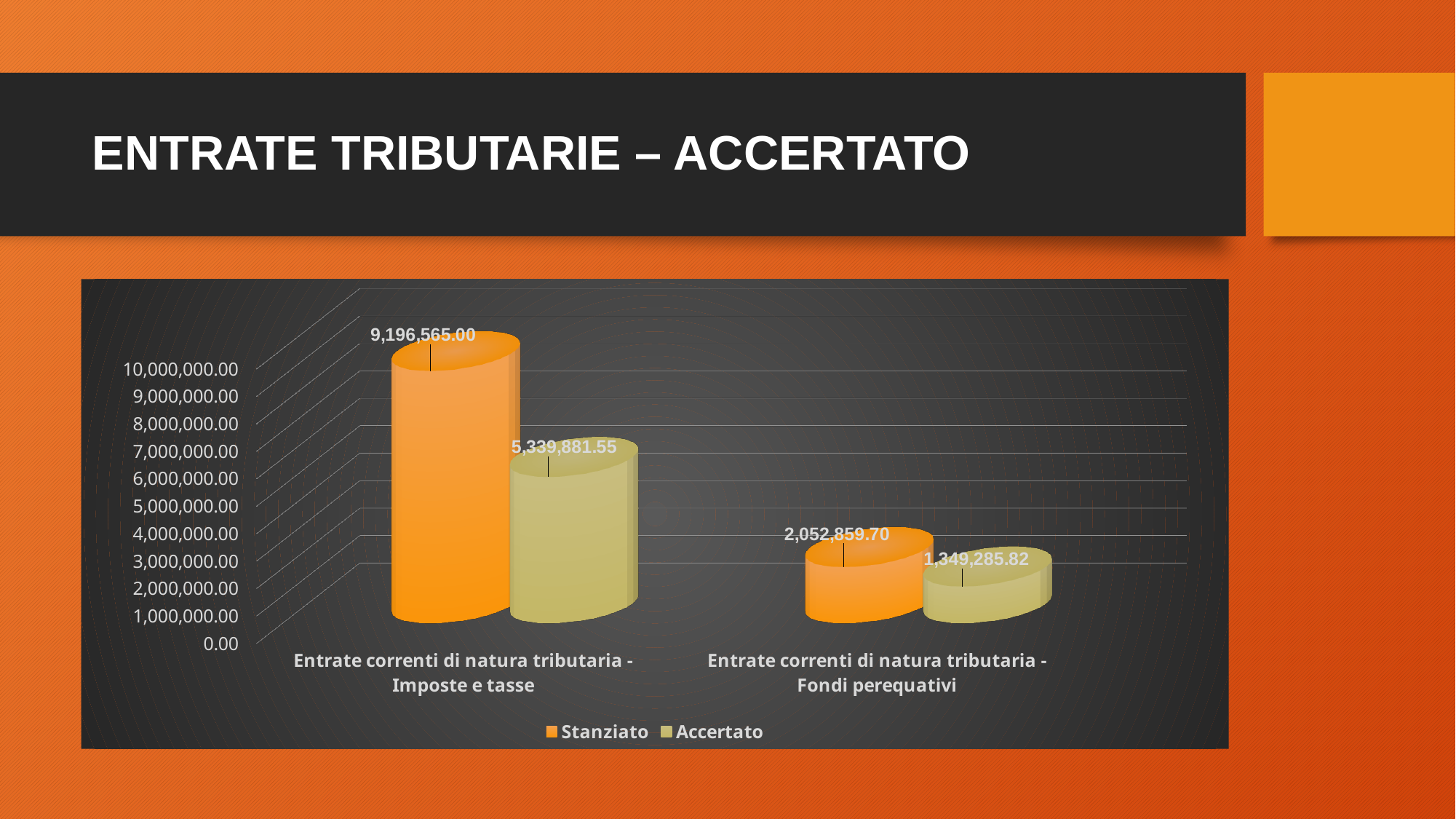
What kind of chart is shown on the slide? Bar chart What is the Stanziato value for 'Entrate correnti di natura tributaria - Imposte e tasse'? 9,196,565.00 What is the difference between the Stanziato and Accertato values for 'Entrate correnti di natura tributaria - Imposte e tasse'? 3,856,683.45 What is the Accertato value for 'Entrate correnti di natura tributaria - Fondi perequativi'? 1,349,285.82 For 'Entrate correnti di natura tributaria - Fondi perequativi', which is larger: Stanziato or Accertato? Stanziato How many categories are shown on the x axis of the chart? 2 Which category has the highest Stanziato value? Entrate correnti di natura tributaria - Imposte e tasse How many series does the chart legend list? 2 What is the Accertato value for 'Entrate correnti di natura tributaria - Imposte e tasse'? 5,339,881.55 What is the difference between the Stanziato and Accertato values for 'Entrate correnti di natura tributaria - Fondi perequativi'? 703,573.88 What is the Stanziato value for 'Entrate correnti di natura tributaria - Fondi perequativi'? 2,052,859.70 Which category has the lowest Accertato value? Entrate correnti di natura tributaria - Fondi perequativi